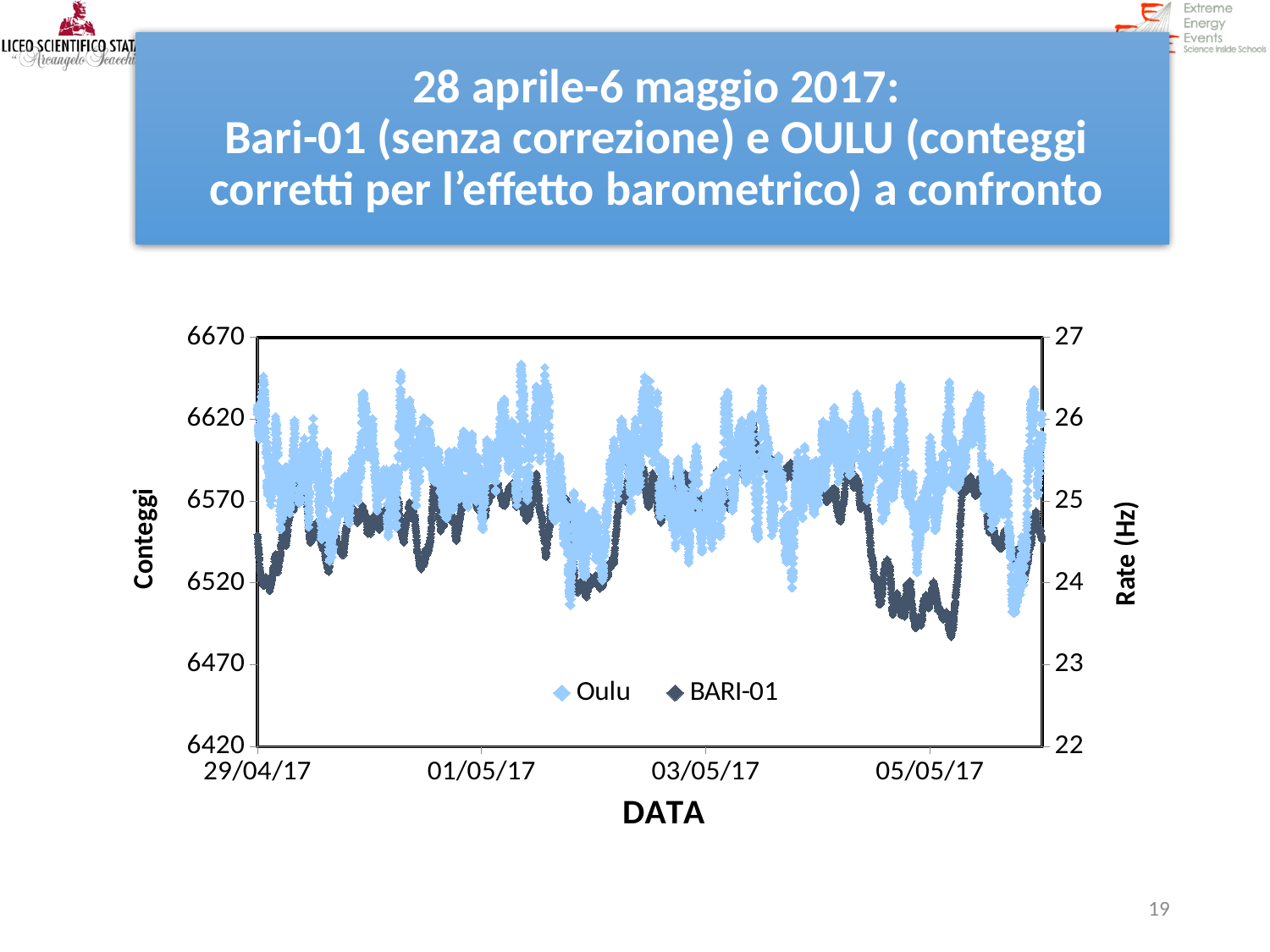
Which series is drawn in light blue in the chart? Oulu What is the maximum value shown on the right vertical axis (Rate (Hz))? 27 What are the names of the two series shown in the chart legend? Oulu and BARI-01 What is the maximum value shown on the left vertical axis (Conteggi)? 6670 What is the first date label shown on the x axis? 29/04/17 Is the lowest BARI-01 value, reached shortly after 05/05/17, greater or less than 24 on the Rate (Hz) axis? less What is the title of the x axis of the chart? DATA What is the minimum value shown on the left vertical axis (Conteggi)? 6420 What is the minimum value shown on the right vertical axis (Rate (Hz))? 22 How many series does the chart legend list? 2 How many date labels are shown on the x axis of the chart? 4 What type of chart is shown on the slide? Scatter chart